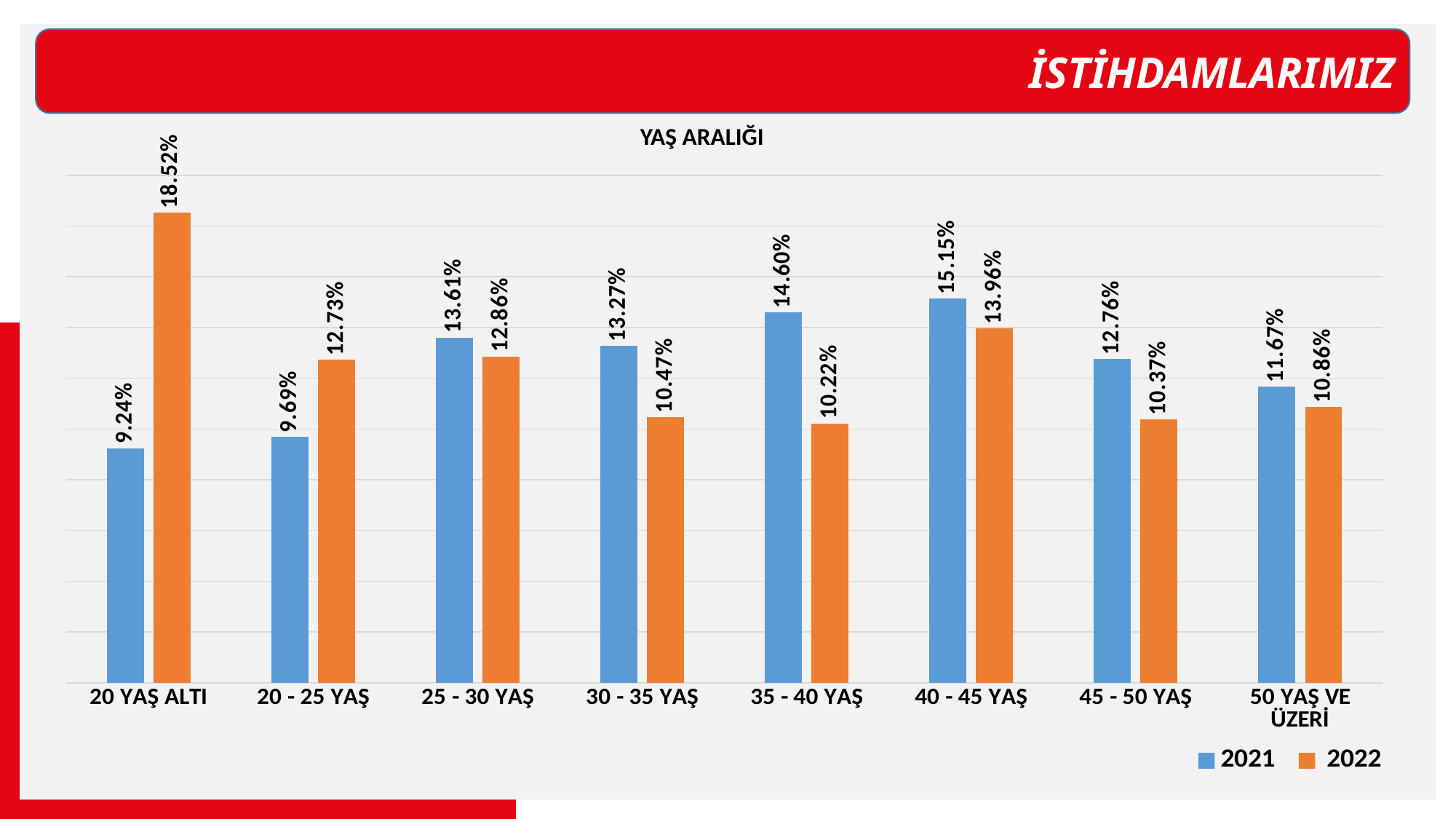
How many series does the legend list? 2 What is the 2022 value for 20 YAŞ ALTI? 18.52% Which age group has the lowest 2021 value? 20 YAŞ ALTI What is the 2022 value for 45 - 50 YAŞ? 10.37% Which age group has the highest 2021 value? 40 - 45 YAŞ How many age groups are shown on the x axis? 8 For 25 - 30 YAŞ, which is larger: the 2021 value or the 2022 value? 2021 Which age group has the lowest 2022 value? 35 - 40 YAŞ What is the 2021 value for 35 - 40 YAŞ? 14.60% What kind of chart is shown on the slide? Bar chart What is the difference between the 2022 and 2021 values for 20 YAŞ ALTI? 9.28 percentage points What is the title of the chart? YAŞ ARALIĞI